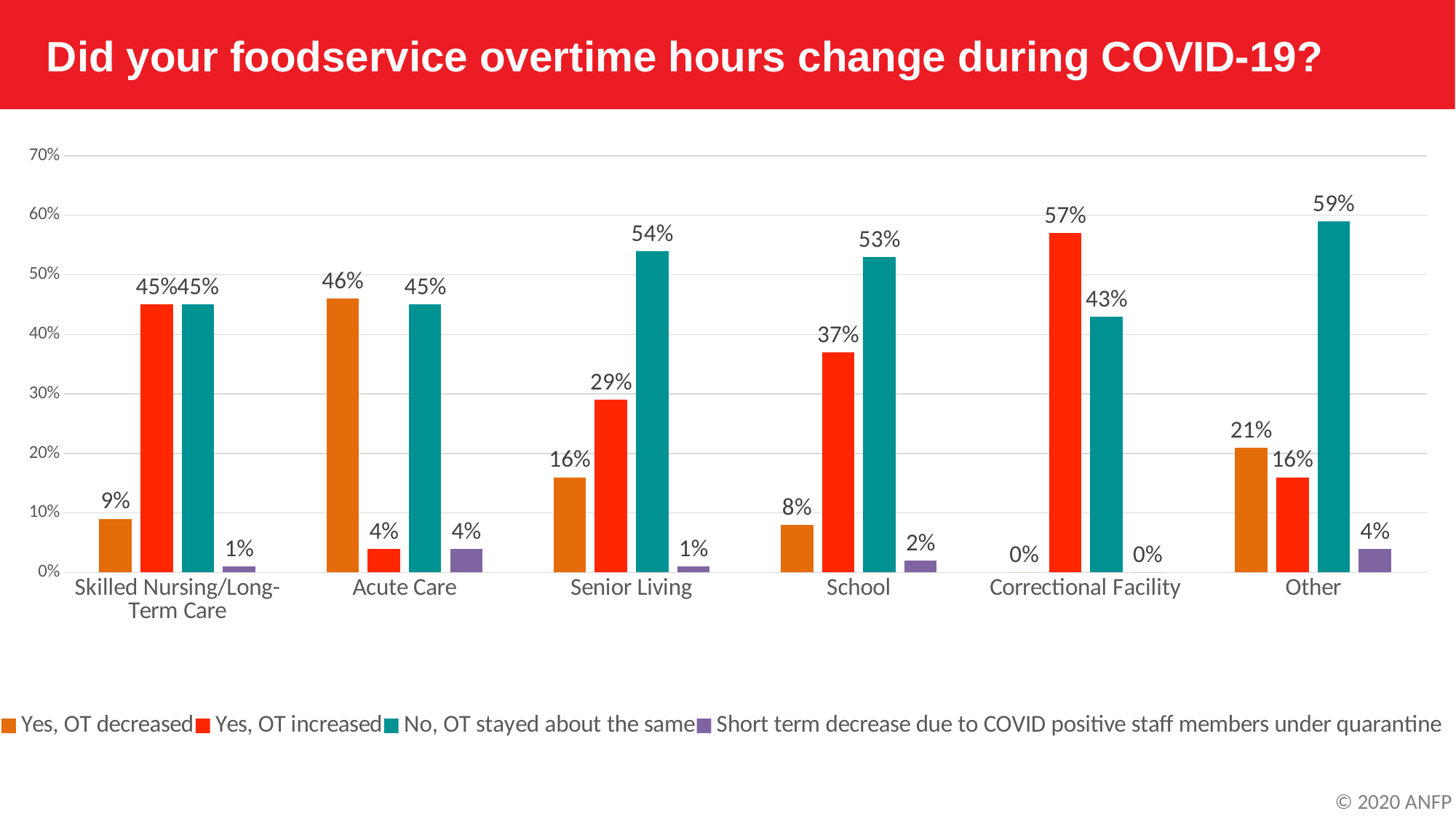
Which category has the lowest value for 'Yes, OT decreased'? Correctional Facility Which is larger in Senior Living: 'Yes, OT decreased' or 'Yes, OT increased'? Yes, OT increased What is the value for 'Short term decrease due to COVID positive staff members under quarantine' in the School category? 2% What is the difference between the 'Yes, OT increased' values for Correctional Facility and School? 20% What percentage of Correctional Facility respondents said OT increased? 57% What is the title of the chart? Did your foodservice overtime hours change during COVID-19? What kind of chart is shown on the slide? Bar chart How many series does the legend list? 4 What is the value for 'No, OT stayed about the same' in the Other category? 59% Which category has the highest value for 'No, OT stayed about the same'? Other How many categories are shown on the x axis? 6 What percentage of Acute Care respondents said OT decreased? 46%